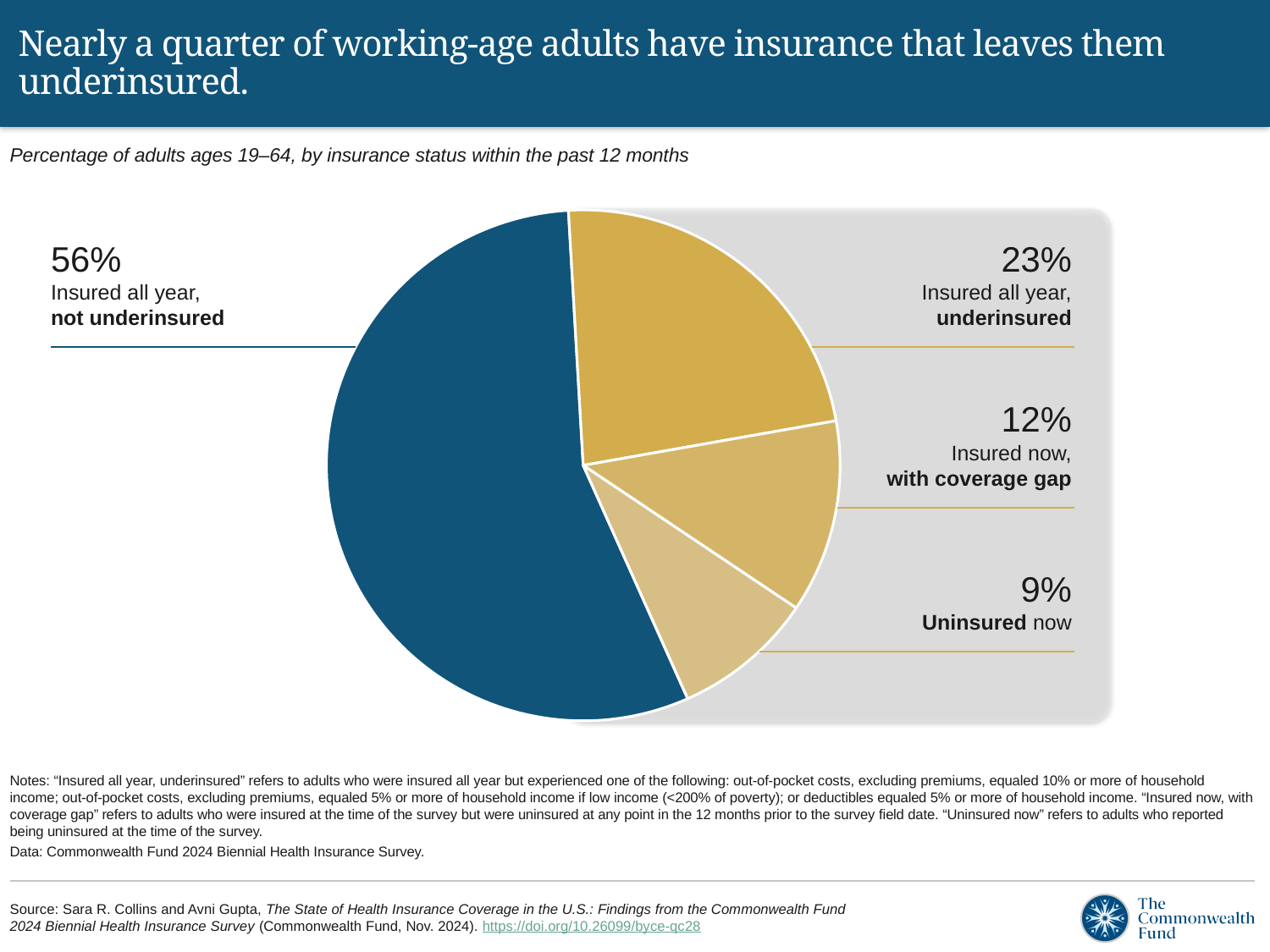
What is the subtitle describing what the chart shows? Percentage of adults ages 19–64, by insurance status within the past 12 months Which is larger: the share insured now, with coverage gap or the share uninsured now? Insured now, with coverage gap What is the combined percentage of adults who were insured all year, underinsured and insured now, with coverage gap? 35% How many insurance status categories are shown in the pie chart? 4 What percentage of adults ages 19–64 were insured now, with coverage gap? 12% What kind of chart is shown on the slide? Pie chart Which insurance status category has the largest share of the pie? Insured all year, not underinsured Which insurance status category has the smallest share of the pie? Uninsured now What is the difference in percentage points between adults insured all year, not underinsured and adults insured all year, underinsured? 33 What percentage of adults ages 19–64 were insured all year, not underinsured? 56% What percentage of adults ages 19–64 were insured all year, underinsured? 23% What percentage of adults ages 19–64 were uninsured now? 9%